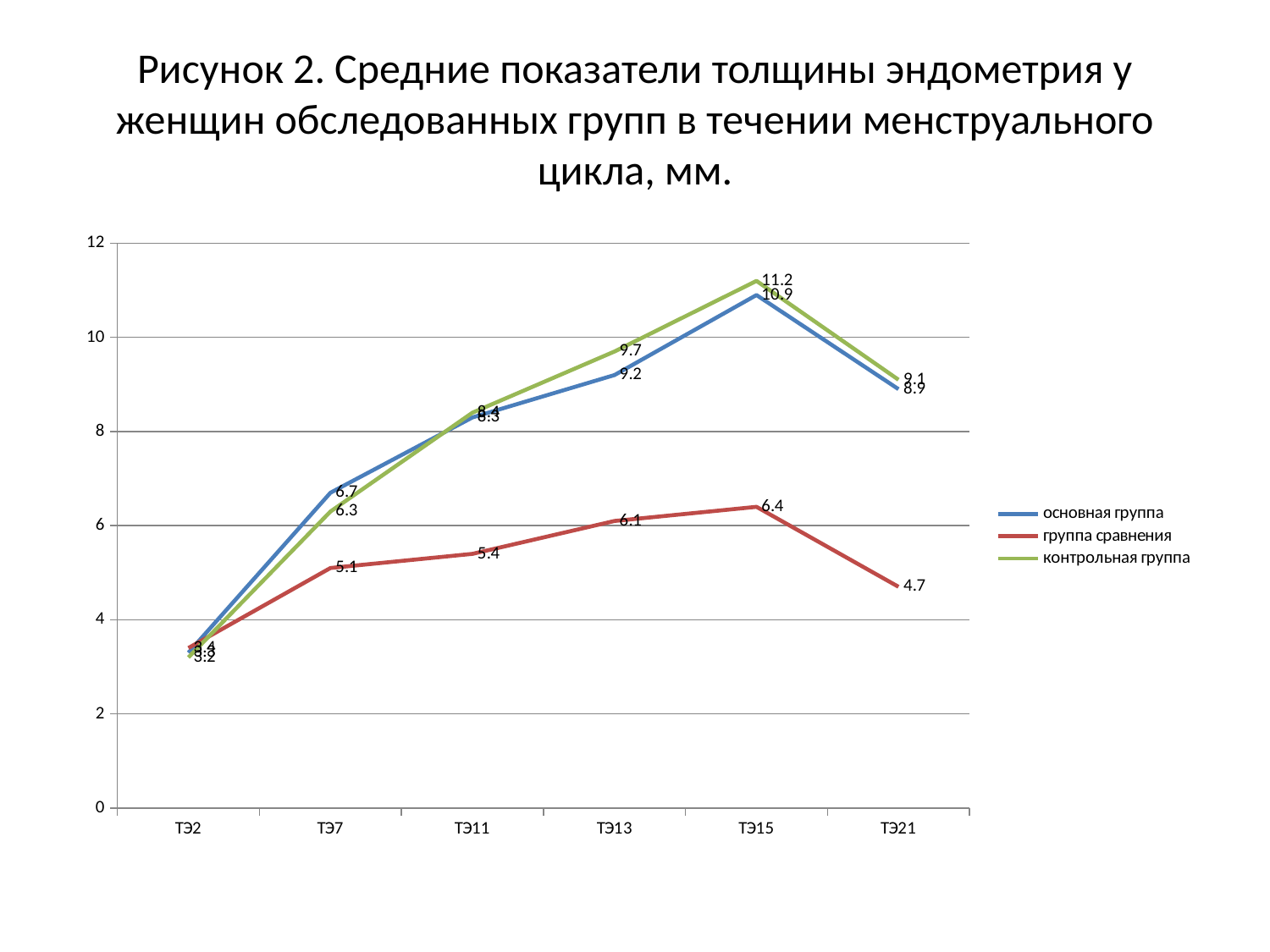
What is the value for группа сравнения at ТЭ7? 5.1 What is the value for контрольная группа at ТЭ15? 11.2 What is the value for группа сравнения at ТЭ21? 4.7 How many categories are shown on the x axis? 6 What is the value for основная группа at ТЭ15? 10.9 At which category does группа сравнения reach its highest value? ТЭ15 What is the difference between контрольная группа and группа сравнения at ТЭ15? 4.8 How many series does the legend list? 3 Which is larger at ТЭ7: основная группа or контрольная группа? основная группа Does the value for группа сравнения rise or fall from ТЭ15 to ТЭ21? fall Is the value for группа сравнения at ТЭ13 greater or less than 8? less What type of chart is shown on the slide? line chart